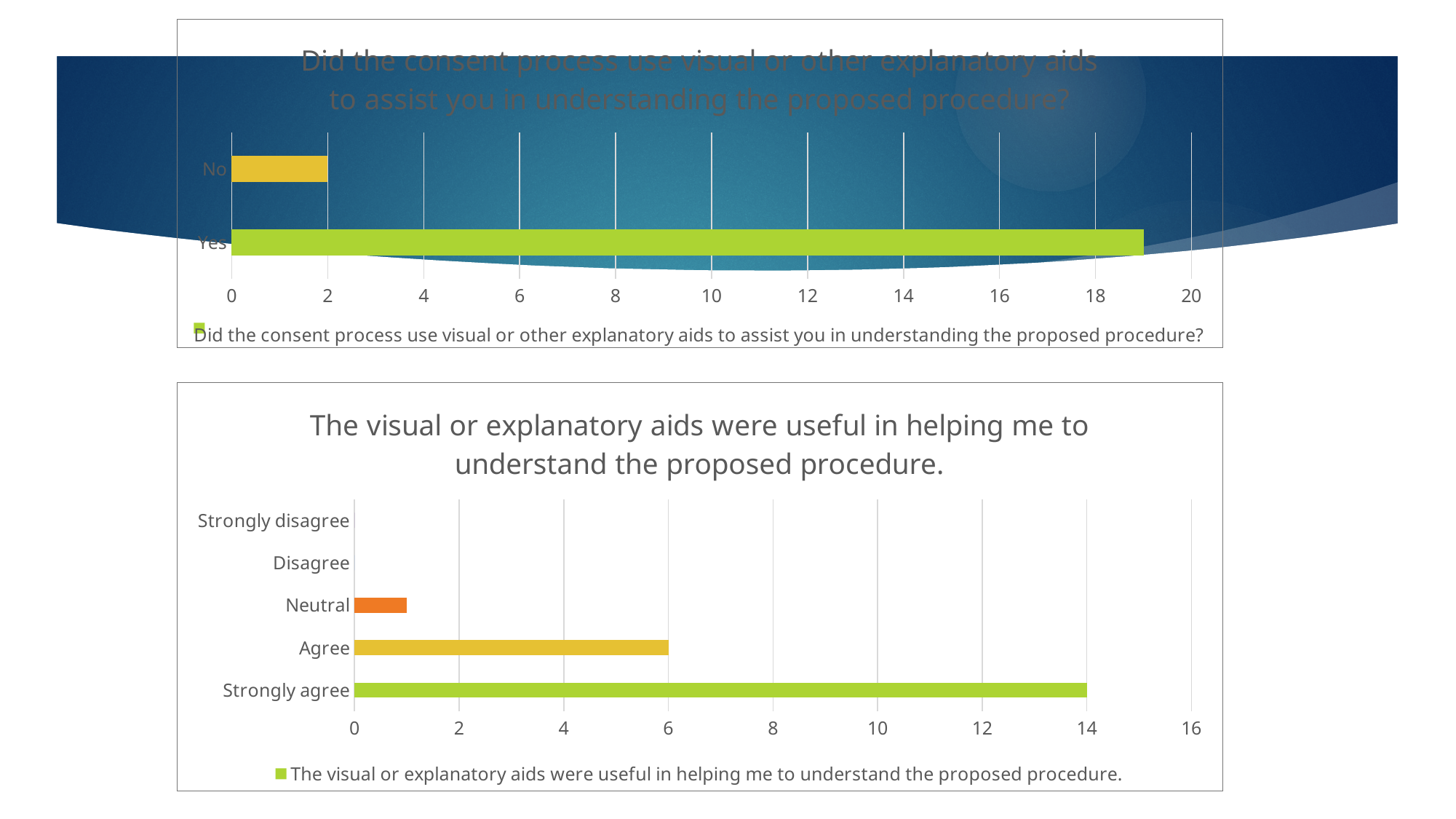
What kind of chart is the top chart, titled "Did the consent process use visual or other explanatory aids to assist you in understanding the proposed procedure?"? bar chart In the top chart, is the value for "Yes" greater or less than 18? greater How many categories are shown in the top chart? 2 In the bottom chart, which category has the highest value? Strongly agree How many series does the legend of the bottom chart list? 1 In the top chart, what is the value for "No"? 2 How many categories are listed on the vertical axis of the bottom chart? 5 In the bottom chart, titled "The visual or explanatory aids were useful in helping me to understand the proposed procedure.", what is the value for "Strongly agree"? 14 In the top chart, which category has the highest value? Yes In the bottom chart, what is the value for "Agree"? 6 In the bottom chart, is the value for "Neutral" greater or less than 2? less In the bottom chart, what is the difference between the values for "Strongly agree" and "Agree"? 8